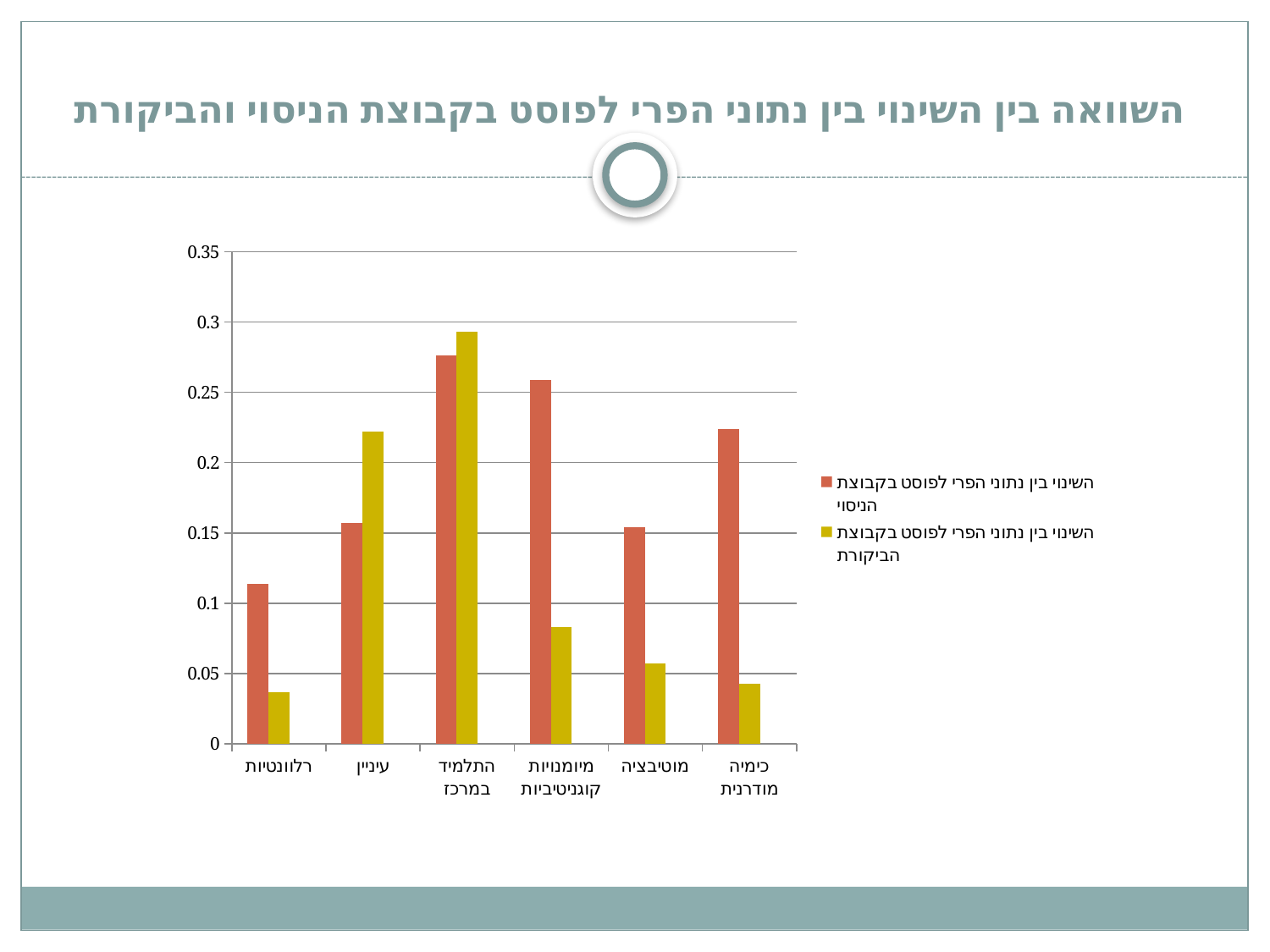
For the category עניין, which series has the larger value: the experimental group (הניסוי) or the control group (הביקורת)? The control group (הביקורת) Is the value for מיומנויות קוגניטיביות in the control group series (הביקורת) greater or less than 0.1? less What colour are the bars for the control group series (השינוי בין נתוני הפרי לפוסט בקבוצת הביקורת)? Yellow What kind of chart is shown on the slide? Bar chart Is the value for התלמיד במרכז in the control group series (הביקורת) greater or less than 0.3? less Which category has the lowest value for the experimental group series (השינוי בין נתוני הפרי לפוסט בקבוצת הניסוי)? רלוונטיות How many series does the legend list? 2 Is the value for רלוונטיות in the experimental group series (הניסוי) greater or less than 0.1? greater Which category has the highest value for the control group series (השינוי בין נתוני הפרי לפוסט בקבוצת הביקורת)? התלמיד במרכז For the category כימיה מודרנית, which series has the larger value: the experimental group (הניסוי) or the control group (הביקורת)? The experimental group (הניסוי) How many categories are shown on the x axis of the chart? 6